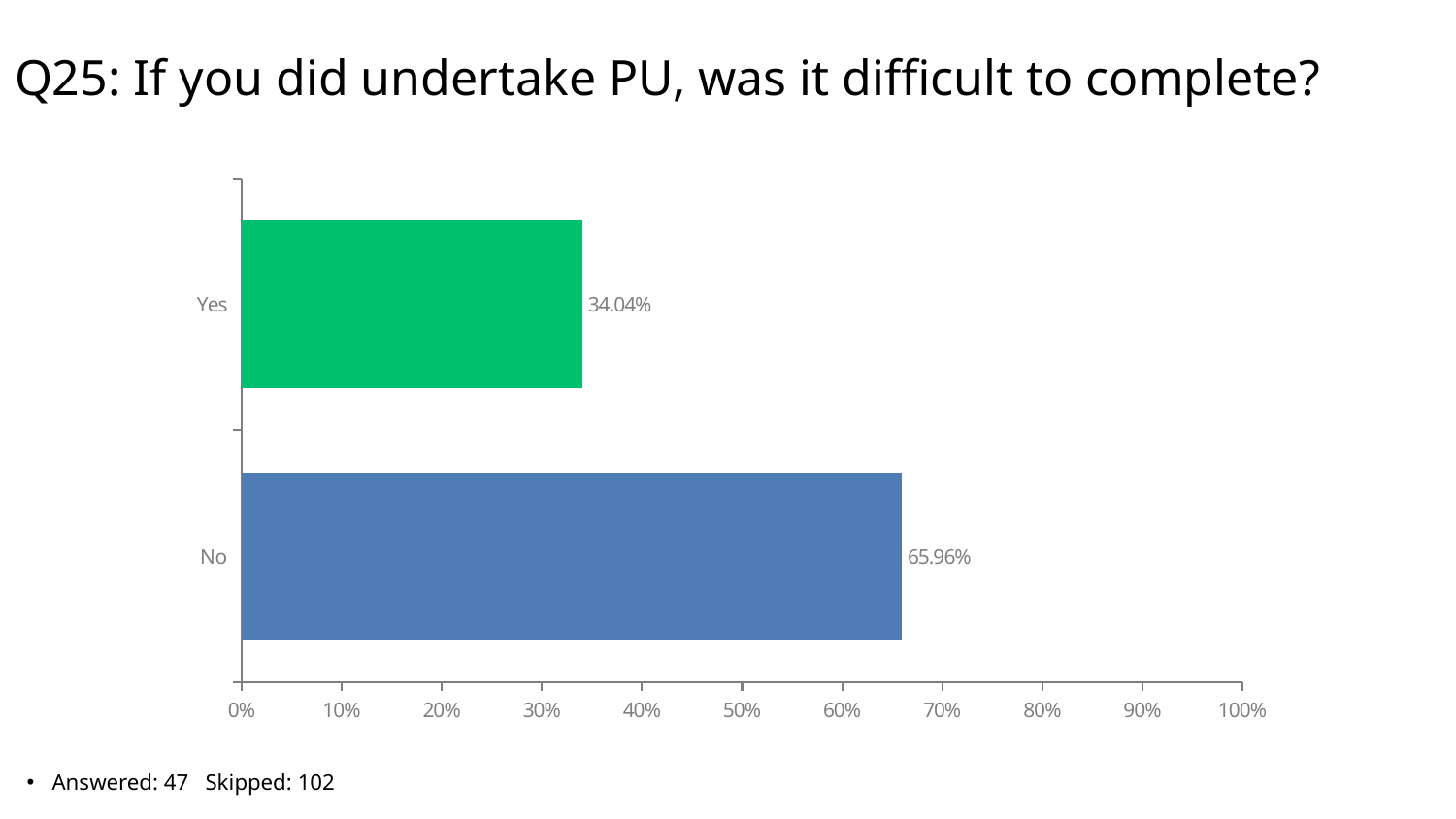
What colour is the bar for Yes? green Which response category has the highest value? No Which is larger, the value for Yes or the value for No? No What percentage of respondents answered No? 65.96% What is the title of the slide? Q25: If you did undertake PU, was it difficult to complete? What kind of chart is shown on the slide? bar chart How many response categories are shown in the chart? 2 Is the value for Yes greater or less than 40%? less Which response category has the lowest value? Yes What is the difference between the No and Yes percentages? 31.92% Is the value for No greater or less than 60%? greater What percentage of respondents answered Yes? 34.04%